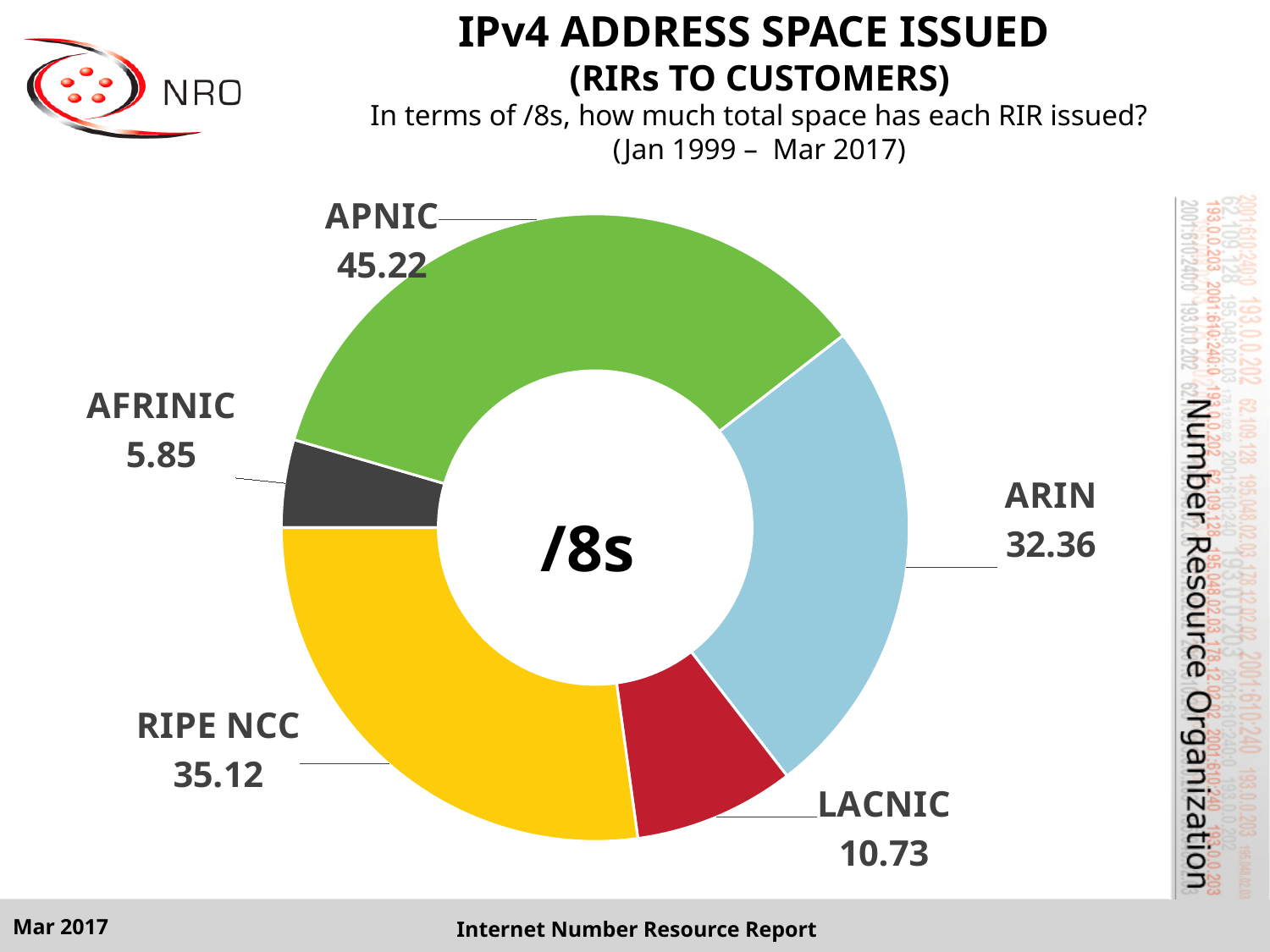
What value is shown for LACNIC? 10.73 What is the difference between the LACNIC and AFRINIC values? 4.88 Which has issued more /8s, RIPE NCC or ARIN? RIPE NCC What is the total of all the values shown in the chart? 129.28 What value is shown for AFRINIC? 5.85 What is the difference between the APNIC and ARIN values? 12.86 Which RIR has issued the least IPv4 address space in /8s? AFRINIC What value is shown for APNIC in the IPv4 address space issued chart? 45.22 Which RIR has issued the most IPv4 address space in /8s? APNIC What kind of chart is used on this slide? doughnut chart How many RIRs are shown as segments in the chart? 5 How many /8s has ARIN issued according to the chart? 32.36